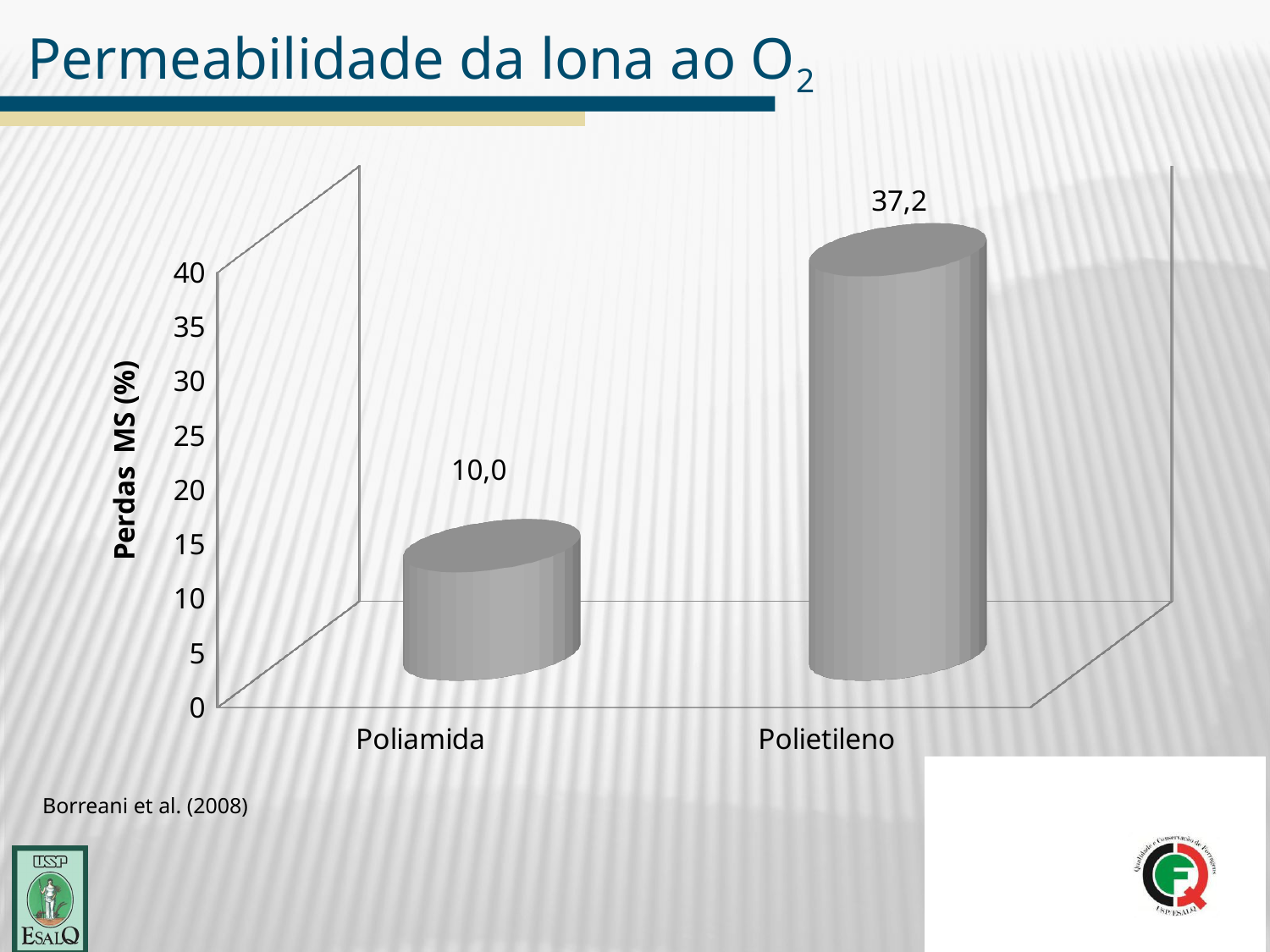
Which category has the lowest value? Poliamida Which category has the highest value? Polietileno What is the title of the slide? Permeabilidade da lona ao O2 What is the difference between the values for Polietileno and Poliamida? 27,2 What is the value for Poliamida? 10,0 How many categories are shown on the chart? 2 Is the value for Polietileno greater or less than 30? greater What kind of chart is shown on the slide? bar chart What is the value for Polietileno? 37,2 What is the label of the vertical axis? Perdas MS (%) Is the value for Poliamida greater or less than 15? less Which is larger, the value for Poliamida or the value for Polietileno? Polietileno